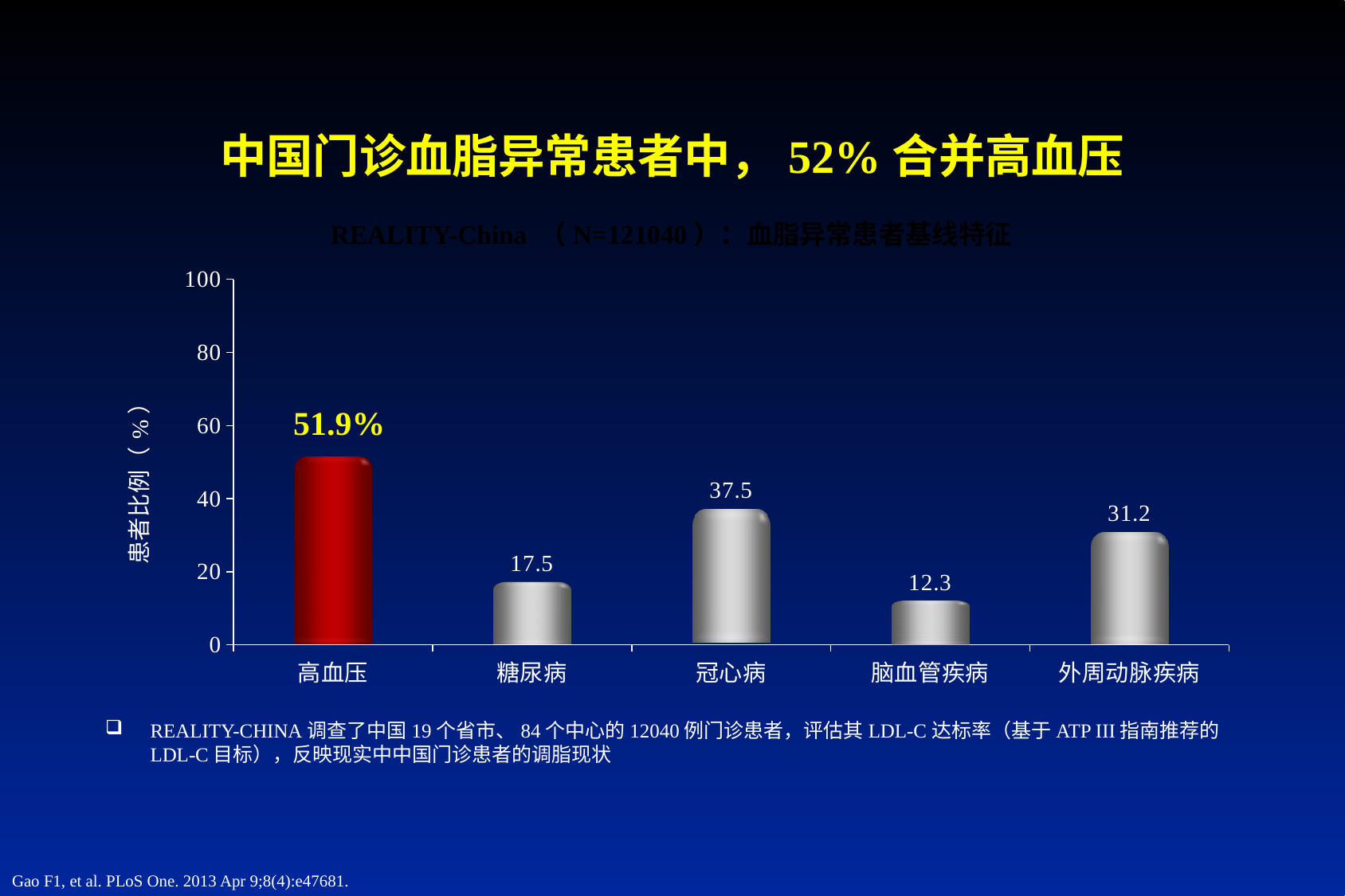
What value is shown for 外周动脉疾病? 31.2 Which is larger, the value for 冠心病 or the value for 外周动脉疾病? 冠心病 Which category has the lowest value? 脑血管疾病 What value is shown for 脑血管疾病? 12.3 What is the label of the y axis? 患者比例（%） What value is shown for 冠心病? 37.5 What value is shown for 高血压? 51.9% Which category has the highest value? 高血压 How many categories are shown on the x axis? 5 What is the difference between the values for 冠心病 and 糖尿病? 20 What kind of chart is this? bar chart What is the difference between the values for 外周动脉疾病 and 脑血管疾病? 18.9